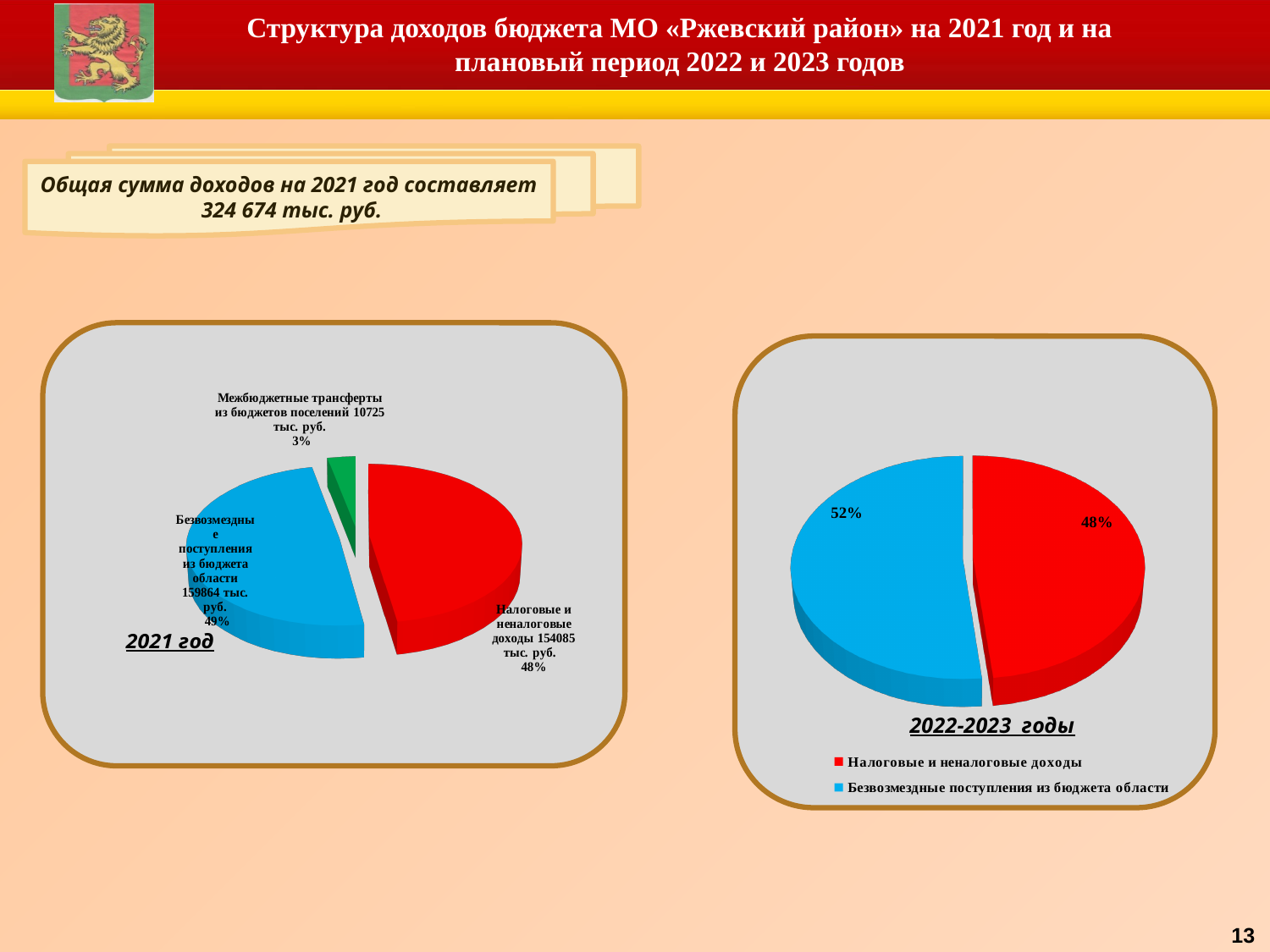
In the «2022-2023 годы» pie chart, what share does «Безвозмездные поступления из бюджета области» have? 52% In the «2021 год» pie chart, what is the difference in тыс. руб. between «Безвозмездные поступления из бюджета области» and «Налоговые и неналоговые доходы»? 5779 тыс. руб. In the «2021 год» pie chart, what is the value for «Налоговые и неналоговые доходы»? 154085 тыс. руб. What type of chart is shown in the left panel labelled «2021 год»? pie chart In the «2022-2023 годы» pie chart, which category has the larger share? Безвозмездные поступления из бюджета области How many entries does the legend of the «2022-2023 годы» pie chart list? 2 In the «2021 год» pie chart, what is the value for «Межбюджетные трансферты из бюджетов поселений»? 10725 тыс. руб. In the «2021 год» pie chart, which category has the smallest share? Межбюджетные трансферты из бюджетов поселений In the «2022-2023 годы» pie chart, what share does «Налоговые и неналоговые доходы» have? 48% In the «2022-2023 годы» pie chart, what colour represents «Налоговые и неналоговые доходы»? red How many slices does the «2021 год» pie chart have? 3 In the «2021 год» pie chart, what share does «Безвозмездные поступления из бюджета области» have? 49%